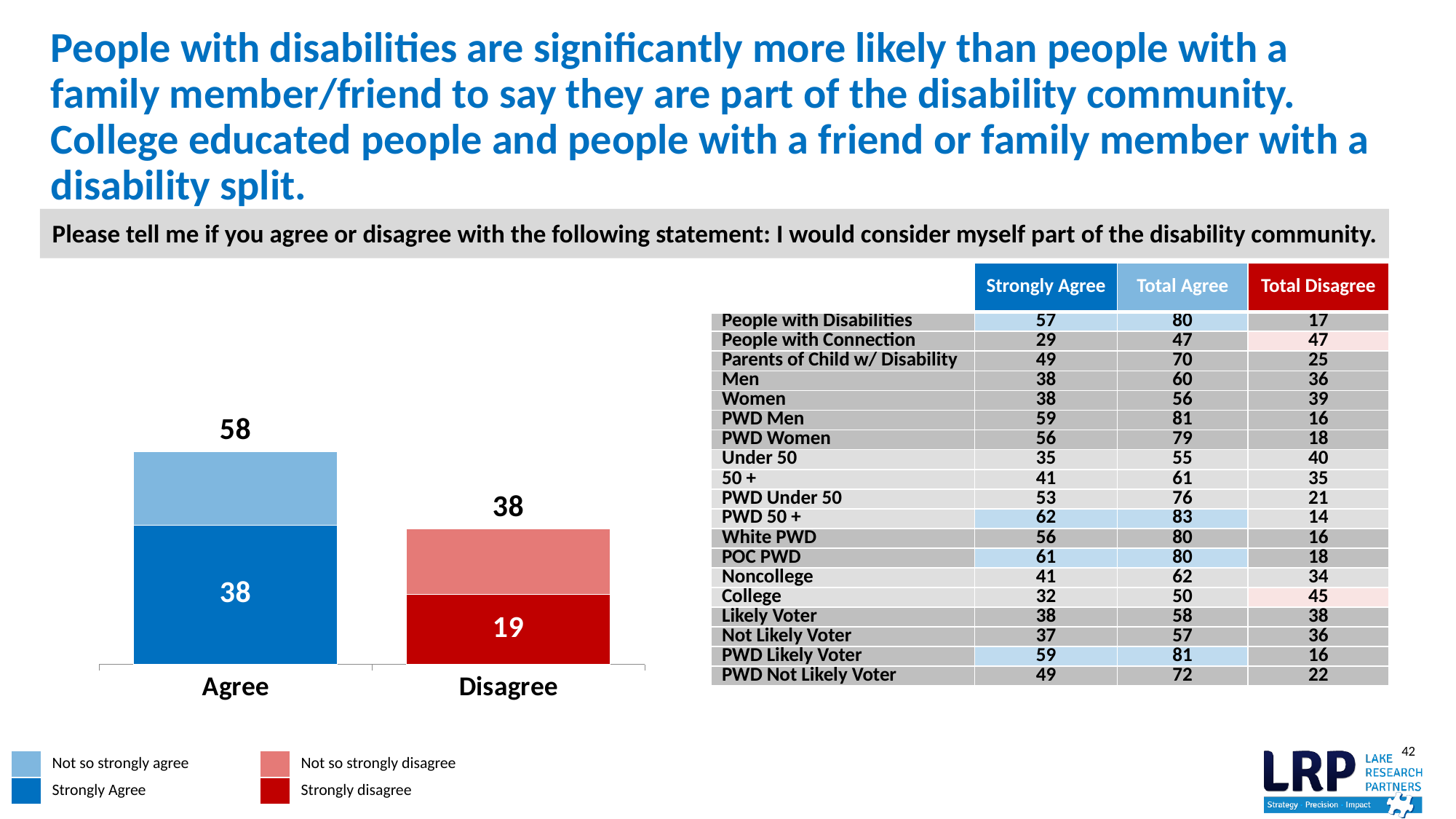
How many entries does the legend list? 4 What is the value of the Strongly Agree segment in the Agree bar? 38 Which bar is taller, Agree or Disagree? Agree What colour is the Strongly disagree segment in the legend? Dark red What kind of chart is shown on the slide? Stacked bar chart What is the difference between the Agree total and the Disagree total? 20 What is the total value shown above the Disagree bar? 38 How many bars are shown in the chart? 2 What is the difference between the Agree total (58) and its Strongly Agree segment (38)? 20 What is the value of the Strongly disagree segment in the Disagree bar? 19 Which of the two bars has the lower total? Disagree What is the total value shown above the Agree bar? 58